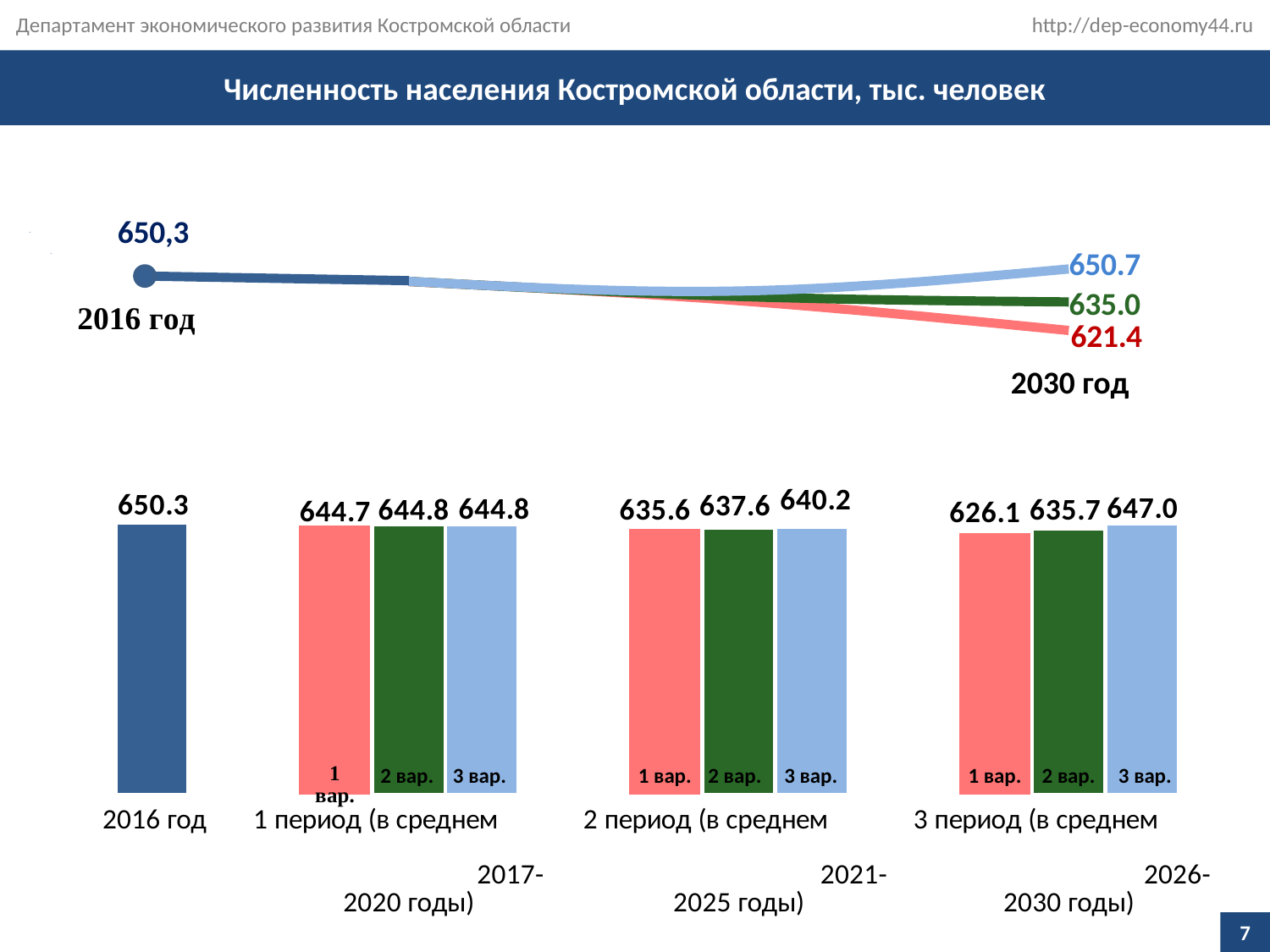
In the top line chart, what is the lowest value shown for 2030 год? 621.4 In the bottom bar chart, what is the value for 1 вар. in 3 период (2026-2030 годы)? 626.1 In the bottom bar chart, what is the difference between 3 вар. and 1 вар. in 3 период? 20.9 What kind of chart is the bottom chart on the slide? bar chart In the bottom bar chart, what is the value for 3 вар. in 2 период (2021-2025 годы)? 640.2 In the bottom bar chart, what is the value for 2016 год? 650.3 In the bottom bar chart, which bar has the lowest value? 1 вар. in 3 период (626.1) In the bottom bar chart, which bar has the highest value? 2016 год (650.3) In the top line chart, what is the difference between the highest and lowest values shown for 2030 год? 29.3 In the bottom bar chart, which is larger: 2 вар. in 2 период or 2 вар. in 3 период? 2 вар. in 2 период (637.6) In the bottom bar chart, do the values for 1 вар. rise or fall from 1 период to 3 период? fall How many bars are plotted in the bottom bar chart? 10